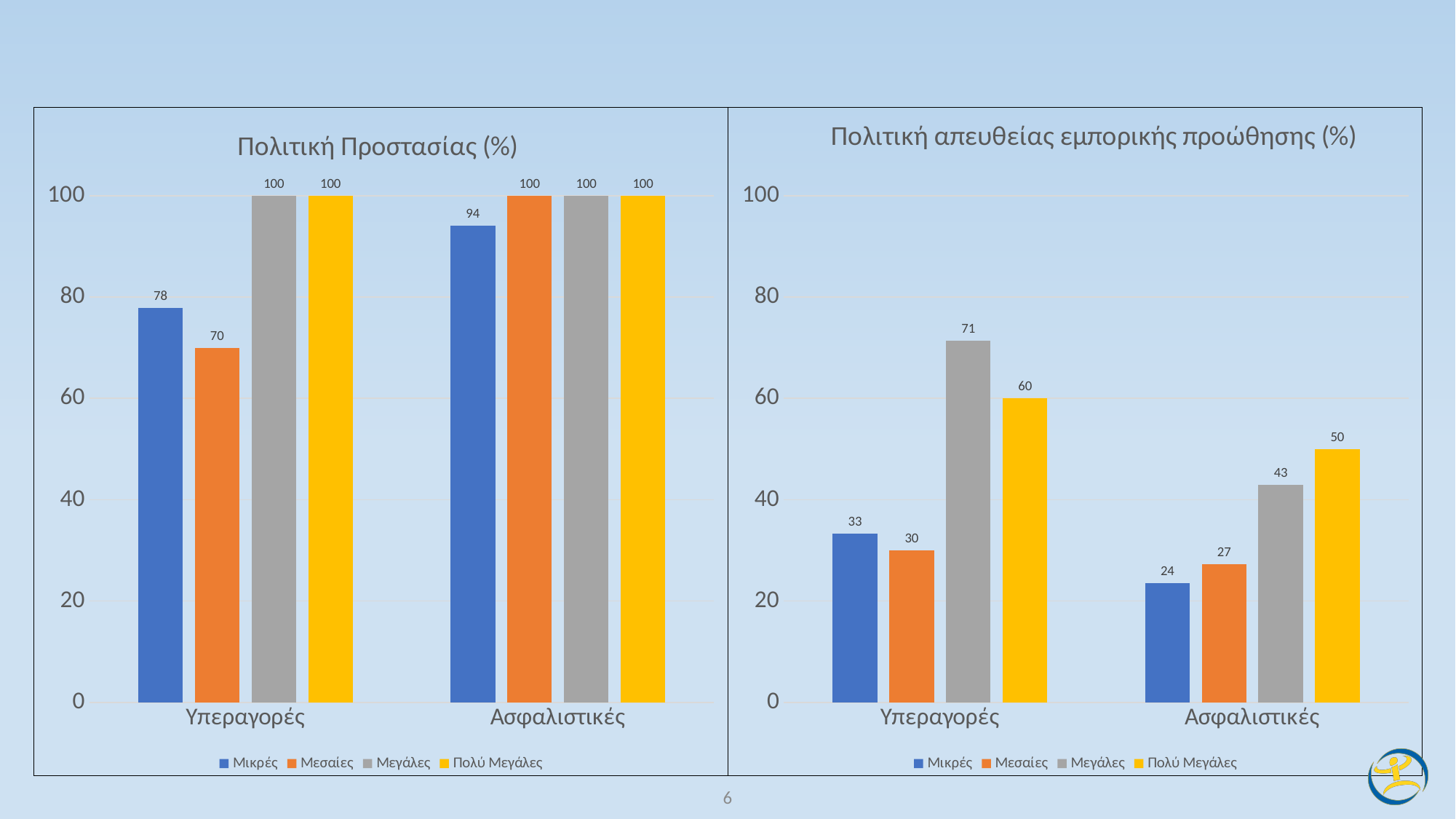
In the chart titled 'Πολιτική απευθείας εμπορικής προώθησης (%)', what is the value for Μεγάλες in the Υπεραγορές category? 71 In the chart titled 'Πολιτική απευθείας εμπορικής προώθησης (%)', what is the value for Πολύ Μεγάλες in the Ασφαλιστικές category? 50 In the chart titled 'Πολιτική Προστασίας (%)', what is the difference between the Μικρές values for Ασφαλιστικές and Υπεραγορές? 16 In the chart titled 'Πολιτική απευθείας εμπορικής προώθησης (%)', which series has the highest value in the Υπεραγορές category? Μεγάλες In the chart titled 'Πολιτική απευθείας εμπορικής προώθησης (%)', which is larger: Μεσαίες for Υπεραγορές or Μεσαίες for Ασφαλιστικές? Μεσαίες for Υπεραγορές How many series does the legend list in the chart titled 'Πολιτική απευθείας εμπορικής προώθησης (%)'? 4 In the chart titled 'Πολιτική Προστασίας (%)', what is the value for Μικρές in the Ασφαλιστικές category? 94 In the chart titled 'Πολιτική Προστασίας (%)', what is the value for Μεσαίες in the Υπεραγορές category? 70 In the chart titled 'Πολιτική Προστασίας (%)', what is the value for Μικρές in the Υπεραγορές category? 78 In the chart titled 'Πολιτική Προστασίας (%)', which series has the lowest value in the Υπεραγορές category? Μεσαίες In the chart titled 'Πολιτική απευθείας εμπορικής προώθησης (%)', which series has the lowest value in the Ασφαλιστικές category? Μικρές What kind of chart is the chart titled 'Πολιτική Προστασίας (%)'? Bar chart